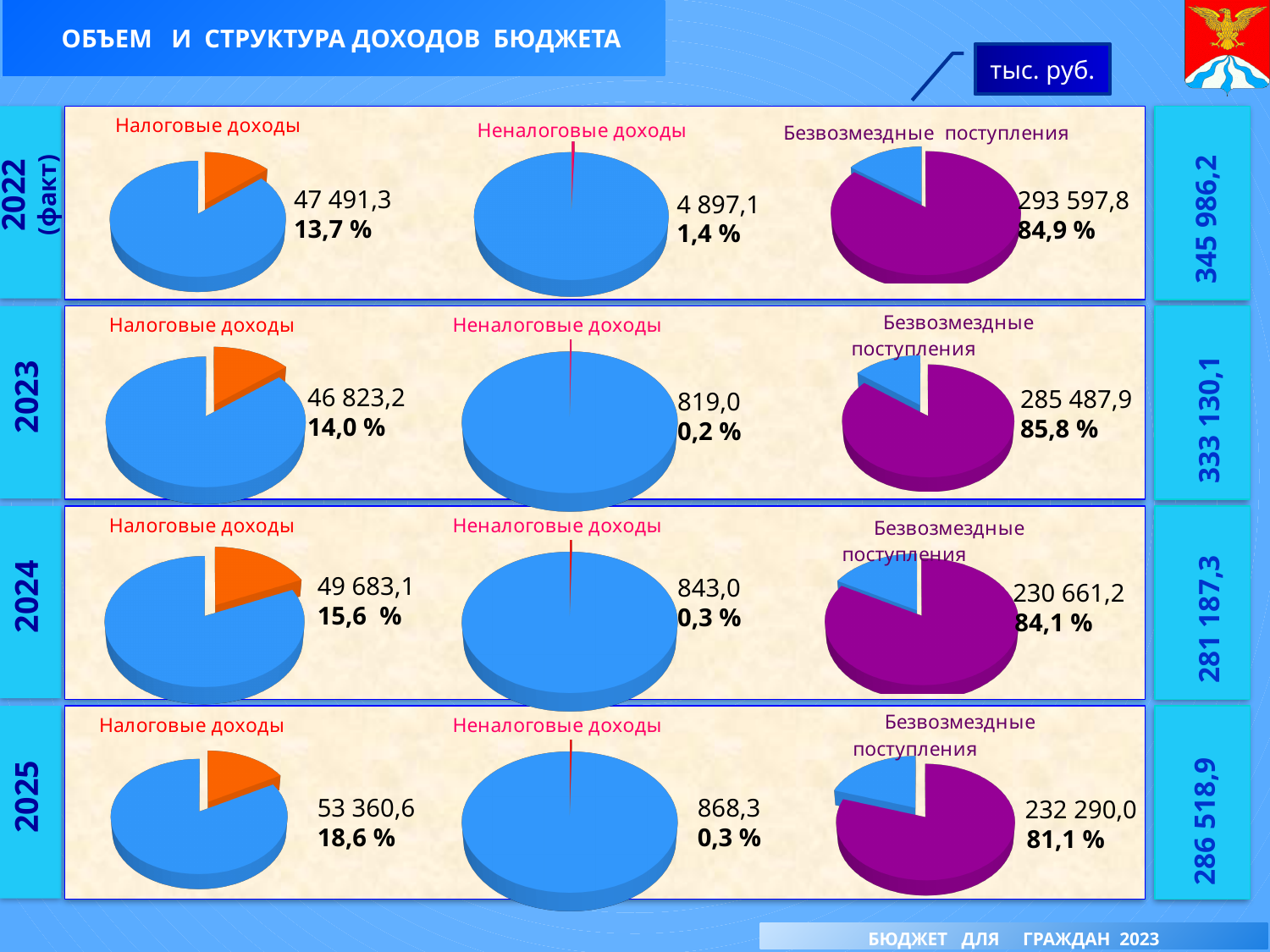
Across the four rows, in which year is the Неналоговые доходы value the highest? 2022 (факт) In the 2023 row, what percentage share is shown on the Налоговые доходы pie chart? 14,0 % In the 2022 (факт) row, what value is shown on the Налоговые доходы pie chart? 47 491,3 In the 2025 row, what value is shown on the Неналоговые доходы pie chart? 868,3 Which is larger: the Налоговые доходы value in the 2025 row or the Налоговые доходы value in the 2024 row? 2025 row (53 360,6) In the 2023 row, what value is shown on the Неналоговые доходы pie chart? 819,0 What is the difference between the Безвозмездные поступления value in the 2022 (факт) row and in the 2023 row? 8 109,9 In the 2022 (факт) row, what percentage share is shown on the Безвозмездные поступления pie chart? 84,9 % How many pie charts are on the slide? 12 In the 2025 row, what percentage share is shown on the Налоговые доходы pie chart? 18,6 % What kind of charts are shown on the slide? Pie charts In the 2024 row, what value is shown on the Безвозмездные поступления pie chart? 230 661,2